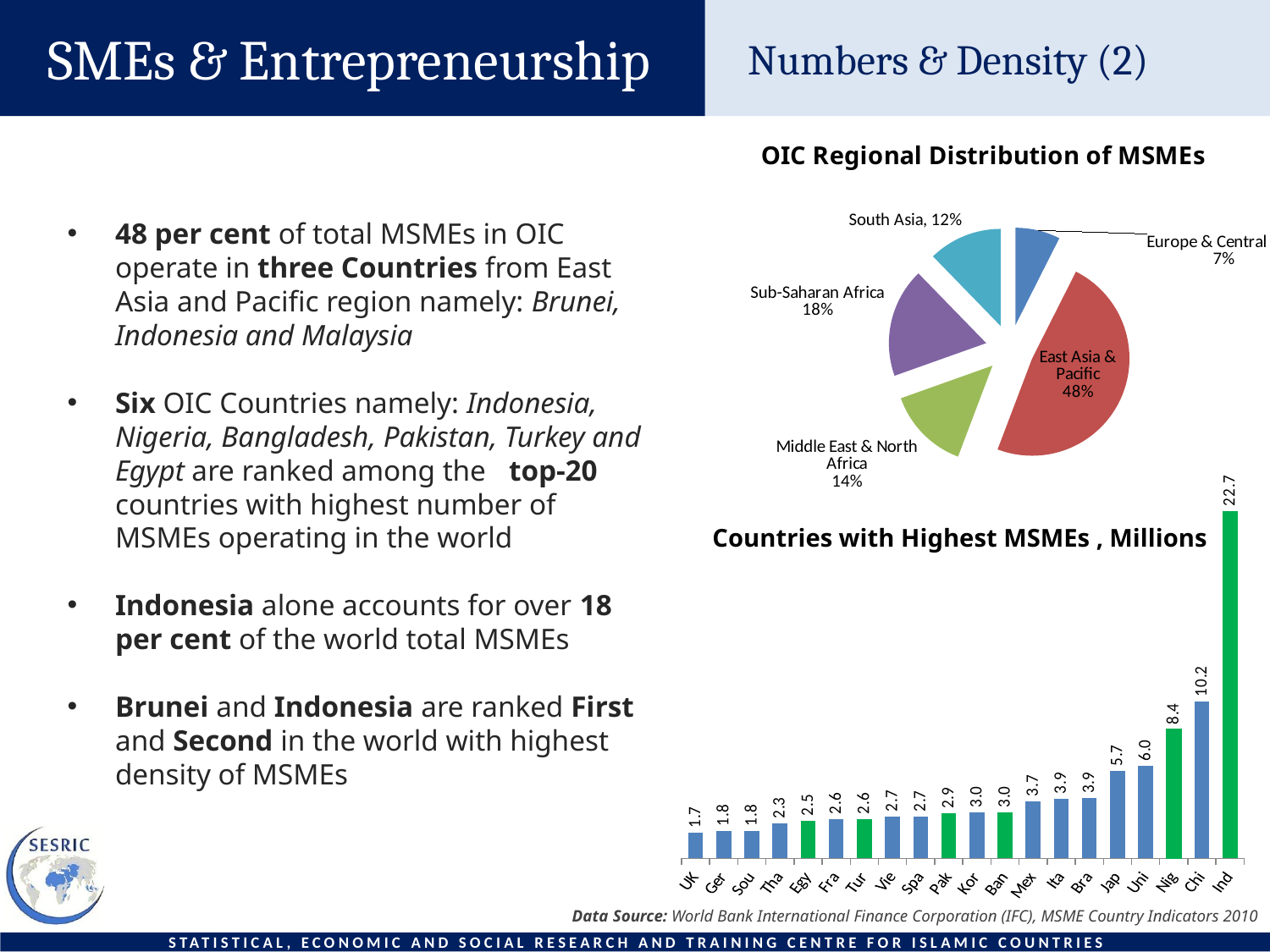
In the 'Countries with Highest MSMEs, Millions' chart, do the values rise or fall from left to right? Rise In the 'Countries with Highest MSMEs, Millions' chart, what is the value for Nig? 8.4 In the 'OIC Regional Distribution of MSMEs' pie chart, what share does Sub-Saharan Africa hold? 18% In the 'OIC Regional Distribution of MSMEs' pie chart, what share does East Asia & Pacific hold? 48% In the 'OIC Regional Distribution of MSMEs' pie chart, which region has the smallest share? Europe & Central Asia In the 'Countries with Highest MSMEs, Millions' chart, what is the value for Ind? 22.7 In the 'OIC Regional Distribution of MSMEs' pie chart, what is the difference in percentage points between Sub-Saharan Africa and Middle East & North Africa? 4 In the 'Countries with Highest MSMEs, Millions' chart, how many countries are shown? 20 What type of chart is 'OIC Regional Distribution of MSMEs'? Pie chart In the 'Countries with Highest MSMEs, Millions' chart, what is the difference between Ind and Chi? 12.5 In the 'OIC Regional Distribution of MSMEs' pie chart, how many regions are shown? 5 In the 'Countries with Highest MSMEs, Millions' chart, which country has the lowest value? UK